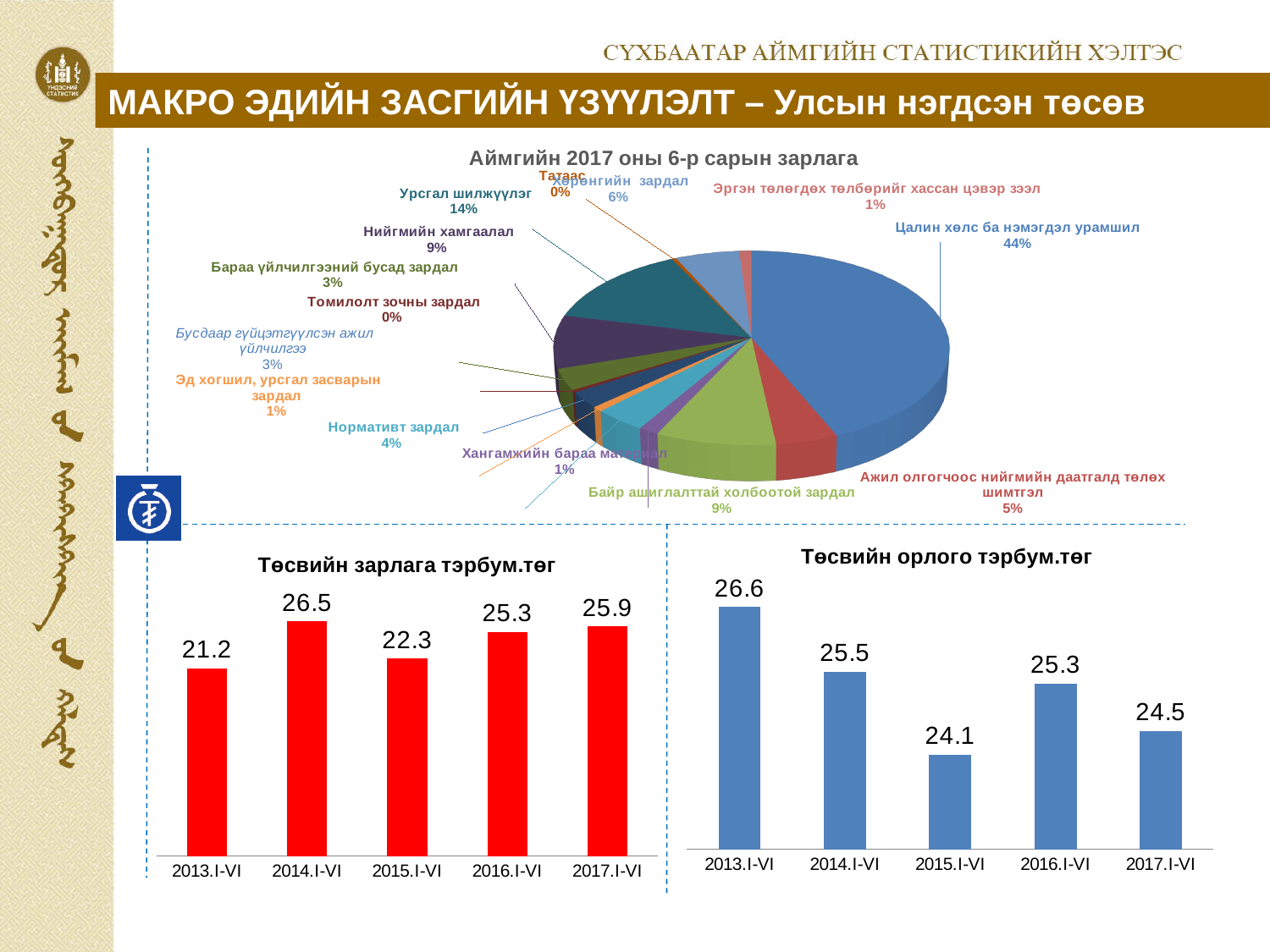
In the pie chart 'Аймгийн 2017 оны 6-р сарын зарлага', which category has the largest share? Цалин хөлс ба нэмэгдэл урамшил In the chart 'Төсвийн орлого тэрбум.төг', which period has the highest value? 2013.I-VI In the pie chart 'Аймгийн 2017 оны 6-р сарын зарлага', what share does 'Цалин хөлс ба нэмэгдэл урамшил' have? 44% What colour are the bars in the chart 'Төсвийн зарлага тэрбум.төг'? red In the chart 'Төсвийн орлого тэрбум.төг', is the value for 2017.I-VI larger or smaller than the value for 2016.I-VI? smaller In the chart 'Төсвийн зарлага тэрбум.төг', what is the difference between the values for 2014.I-VI and 2013.I-VI? 5.3 In the pie chart 'Аймгийн 2017 оны 6-р сарын зарлага', what share does 'Урсгал шилжүүлэг' have? 14% In the chart 'Төсвийн зарлага тэрбум.төг', which period has the lowest value? 2013.I-VI In the chart 'Төсвийн орлого тэрбум.төг', what is the value for 2015.I-VI? 24.1 What kind of chart is 'Аймгийн 2017 оны 6-р сарын зарлага'? pie chart In the chart 'Төсвийн зарлага тэрбум.төг', what is the value for 2014.I-VI? 26.5 How many periods are shown on the x axis of the chart 'Төсвийн зарлага тэрбум.төг'? 5